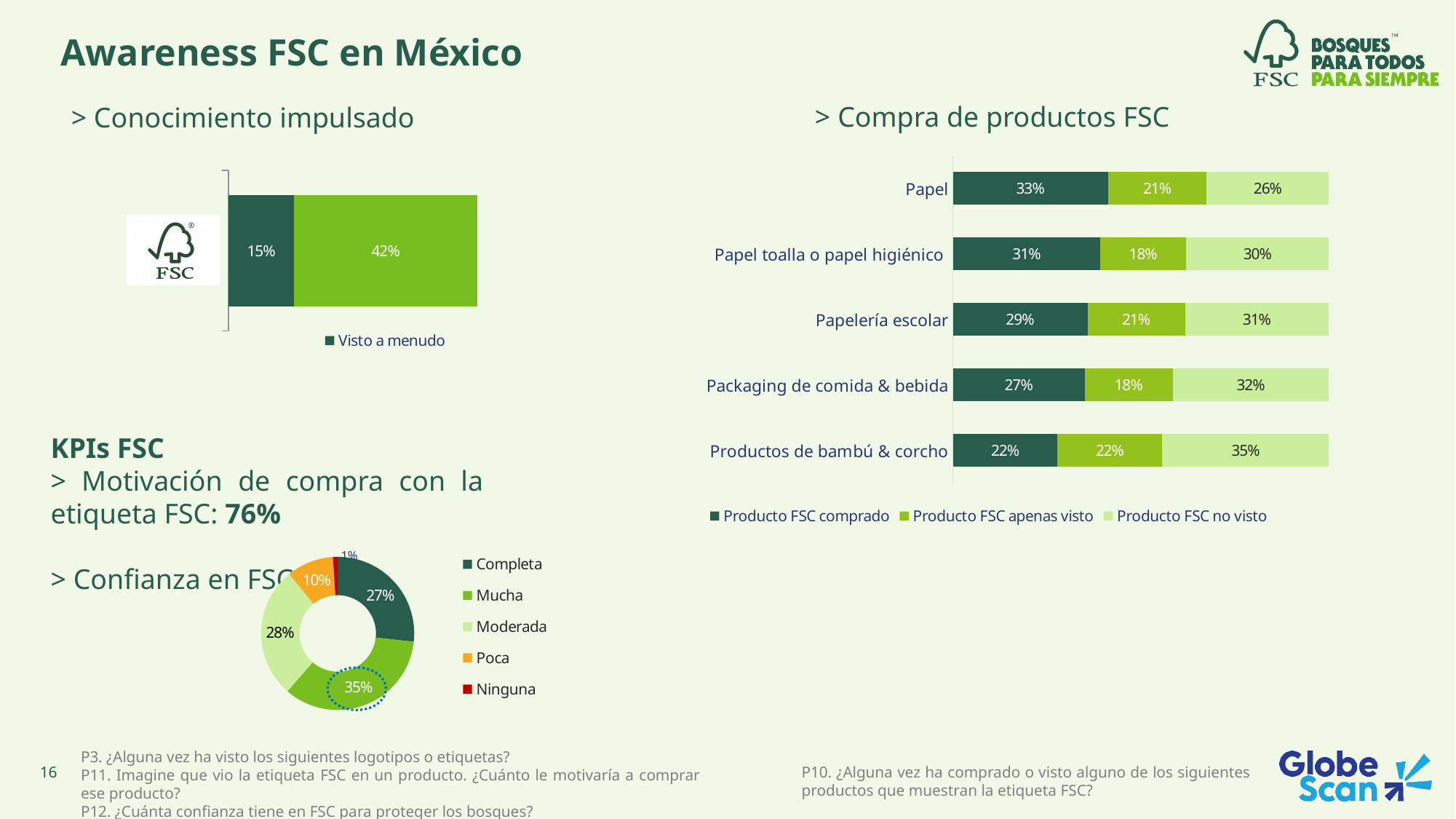
How many product categories are shown in the 'Compra de productos FSC' chart? 5 In the 'Confianza en FSC' chart, which slice is the smallest? Ninguna In the 'Compra de productos FSC' chart, what is the value of 'Producto FSC no visto' for Productos de bambú & corcho? 35% In the 'Compra de productos FSC' chart, which category has the highest 'Producto FSC comprado' value? Papel In the 'Compra de productos FSC' chart, what is the value of 'Producto FSC comprado' for Papel? 33% In the 'Confianza en FSC' chart, what share does 'Mucha' have? 35% In the 'Compra de productos FSC' chart, which category has the lowest 'Producto FSC no visto' value? Papel In the 'Compra de productos FSC' chart, what is the total of the three segments for Papelería escolar? 81% In the 'Compra de productos FSC' chart, what is the difference between the 'Producto FSC comprado' values for Papel and Productos de bambú & corcho? 11 percentage points What kind of chart is the 'Confianza en FSC' chart? Donut (pie) chart In the 'Conocimiento impulsado' chart, what is the value of the dark green segment labelled 'Visto a menudo'? 15% How many series does the legend of the 'Compra de productos FSC' chart list? 3